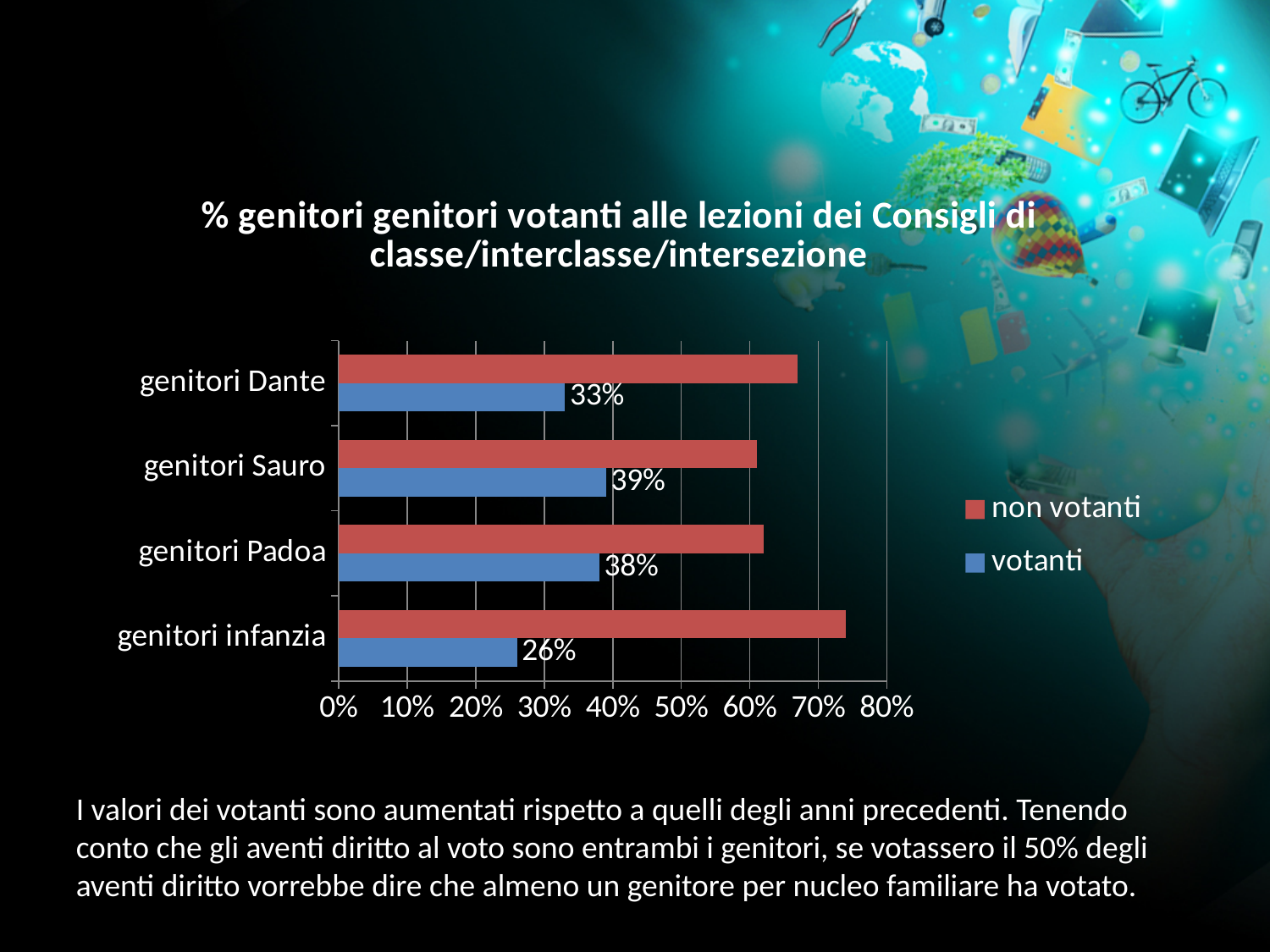
What is the votanti value for genitori Sauro? 39% Which category has the highest non votanti value? genitori infanzia What is the votanti value for genitori Padoa? 38% What type of chart is shown on the slide? bar chart What is the votanti value for genitori infanzia? 26% Is the non votanti value for genitori infanzia greater or less than 70%? greater What is the votanti value for genitori Dante? 33% Which category has the highest votanti value? genitori Sauro How many series does the legend list? 2 What is the difference between the votanti values for genitori Sauro and genitori infanzia? 13% How many categories are shown on the chart? 4 Which category has the lowest votanti value? genitori infanzia